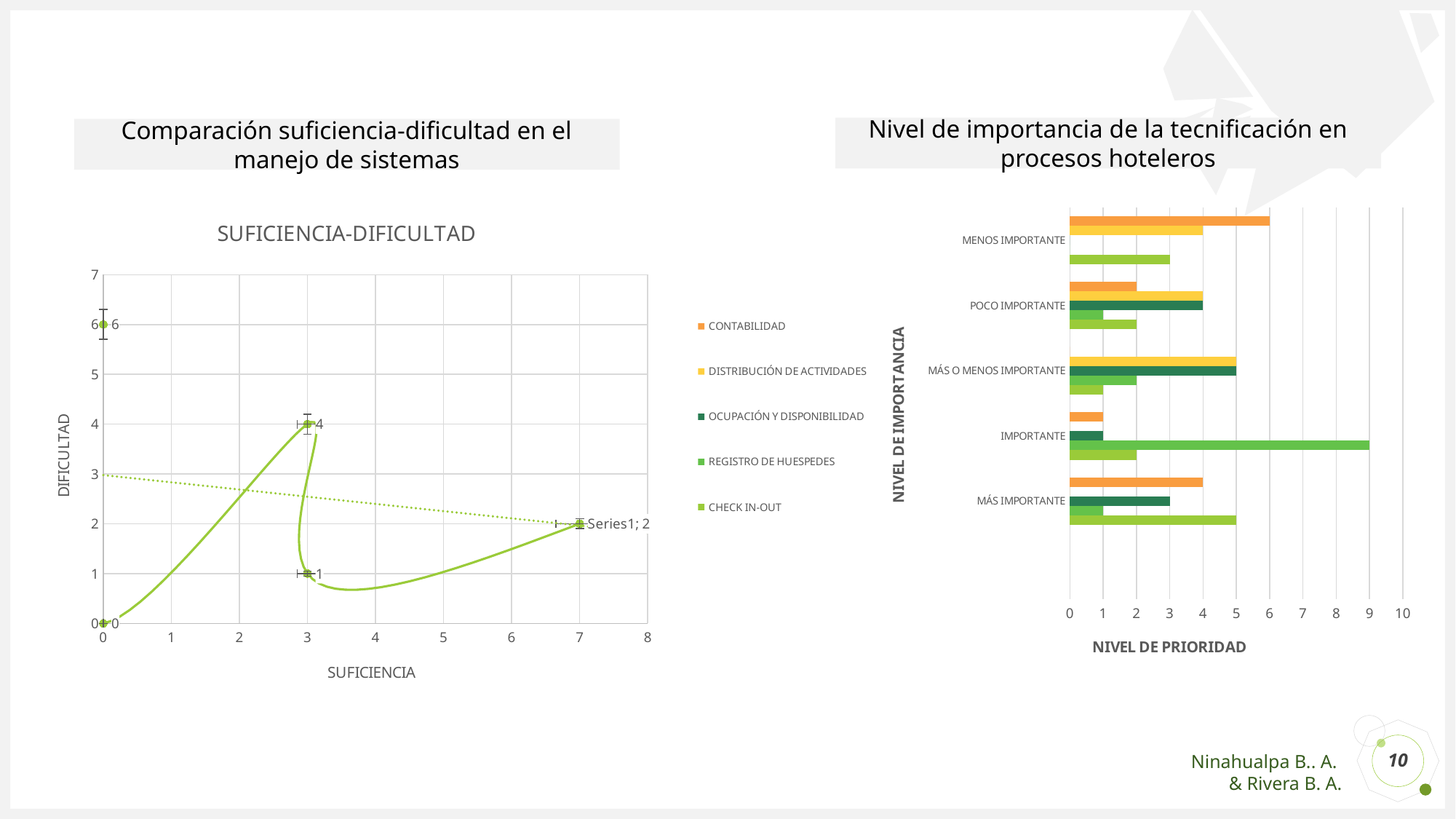
In the chart titled 'SUFICIENCIA-DIFICULTAD', what is the DIFICULTAD value of the point at SUFICIENCIA 7? 2 What is the title of the horizontal axis of the chart titled 'Nivel de importancia de la tecnificación en procesos hoteleros'? NIVEL DE PRIORIDAD In the chart titled 'SUFICIENCIA-DIFICULTAD', what is the highest DIFICULTAD value labelled on a point? 6 In the chart titled 'Nivel de importancia de la tecnificación en procesos hoteleros', what is the difference between the CONTABILIDAD value and the CHECK IN-OUT value in the MENOS IMPORTANTE category? 3 In the chart titled 'Nivel de importancia de la tecnificación en procesos hoteleros', which series has the highest value in the IMPORTANTE category? REGISTRO DE HUESPEDES In the chart titled 'Nivel de importancia de la tecnificación en procesos hoteleros', is the value for CONTABILIDAD in the MÁS IMPORTANTE category larger or smaller than the value for OCUPACIÓN Y DISPONIBILIDAD in the same category? larger In the chart titled 'Nivel de importancia de la tecnificación en procesos hoteleros', what is the value for CONTABILIDAD in the MENOS IMPORTANTE category? 6 How many categories are shown on the vertical axis of the chart titled 'Nivel de importancia de la tecnificación en procesos hoteleros'? 5 What kind of chart is the chart titled 'Nivel de importancia de la tecnificación en procesos hoteleros'? bar chart In the chart titled 'Nivel de importancia de la tecnificación en procesos hoteleros', what is the value for CHECK IN-OUT in the MÁS IMPORTANTE category? 5 How many series does the legend of the chart titled 'Nivel de importancia de la tecnificación en procesos hoteleros' list? 5 In the chart titled 'Nivel de importancia de la tecnificación en procesos hoteleros', what is the value for REGISTRO DE HUESPEDES in the IMPORTANTE category? 9